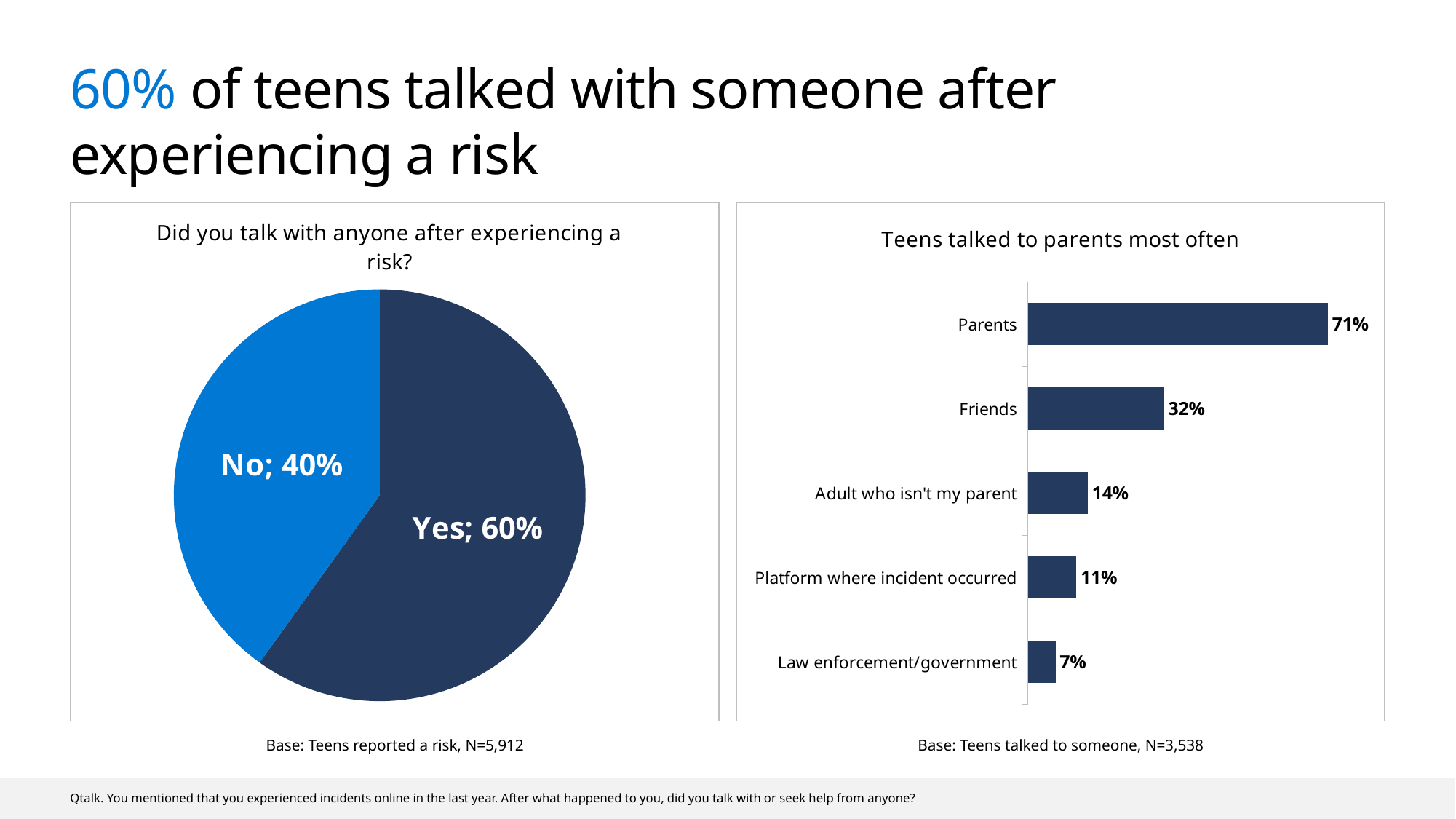
How many categories are shown in the chart 'Teens talked to parents most often'? 5 In the pie chart 'Did you talk with anyone after experiencing a risk?', what share of teens answered Yes? 60% In the chart 'Teens talked to parents most often', what is the value for Friends? 32% In the pie chart 'Did you talk with anyone after experiencing a risk?', what share of teens answered No? 40% In the chart 'Teens talked to parents most often', which category has the highest value? Parents In the chart 'Teens talked to parents most often', which category has the lowest value? Law enforcement/government In the chart 'Teens talked to parents most often', what is the difference between the values for Parents and Friends? 39% What kind of chart is the right chart, 'Teens talked to parents most often'? bar chart In the pie chart on the left, how many slices are there? 2 In the chart 'Teens talked to parents most often', what is the value for Platform where incident occurred? 11% In the chart 'Teens talked to parents most often', which is larger: the value for Adult who isn't my parent or the value for Platform where incident occurred? Adult who isn't my parent What kind of chart is the left chart, 'Did you talk with anyone after experiencing a risk?'? pie chart